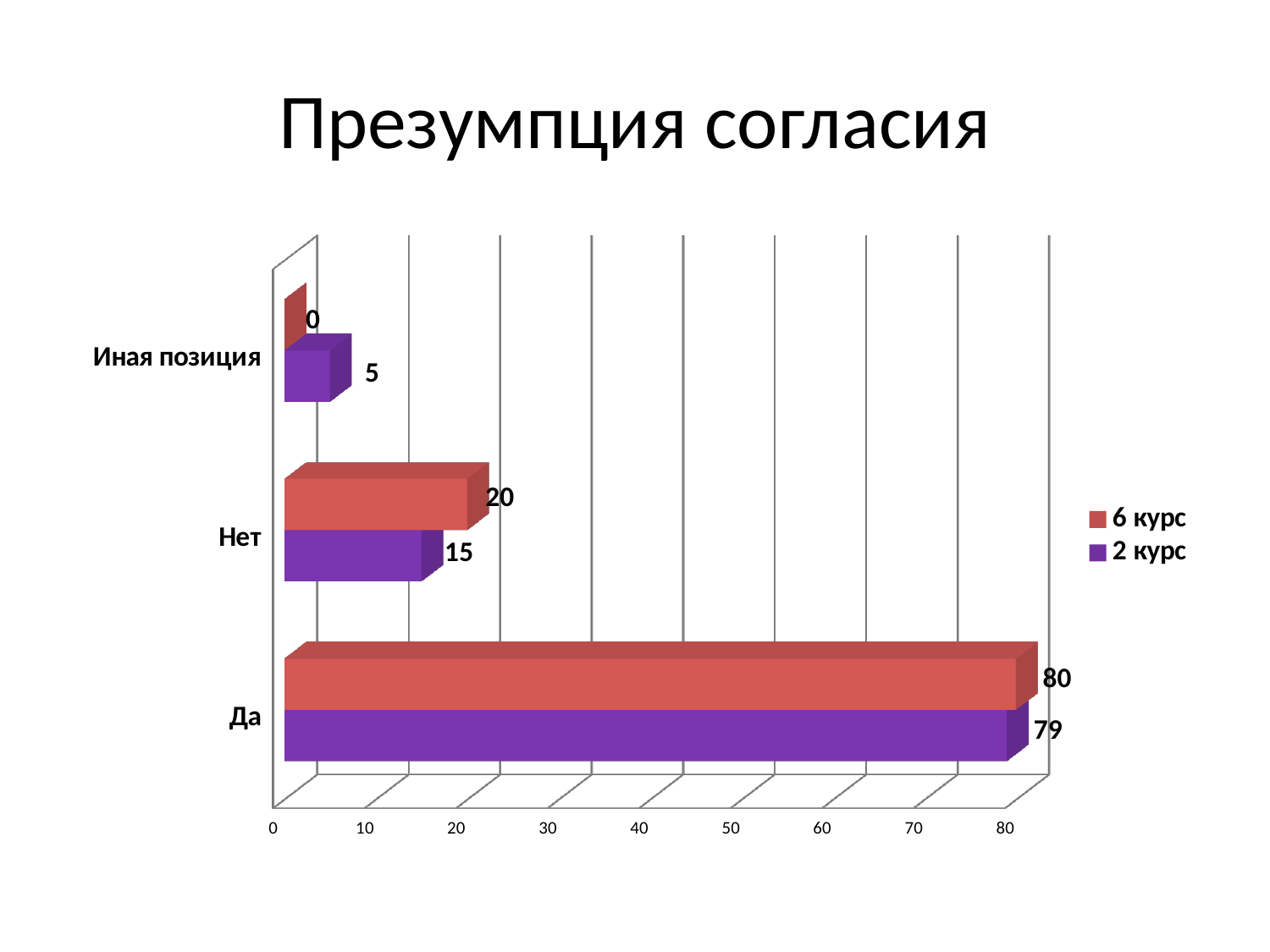
What is the difference between the "6 курс" and "2 курс" values for "Нет"? 5 What is the value for "Да" in the "6 курс" series? 80 What is the title of the slide? Презумпция согласия How many series does the legend list? 2 Which category has the highest value in the "2 курс" series? Да What is the value for "Иная позиция" in the "2 курс" series? 5 What is the value for "Нет" in the "2 курс" series? 15 How many categories are shown on the chart? 3 For "Иная позиция", which series has the larger value, "6 курс" or "2 курс"? 2 курс Which category has the lowest value in the "6 курс" series? Иная позиция What kind of chart is shown on the slide? Bar chart What is the value for "Иная позиция" in the "6 курс" series? 0